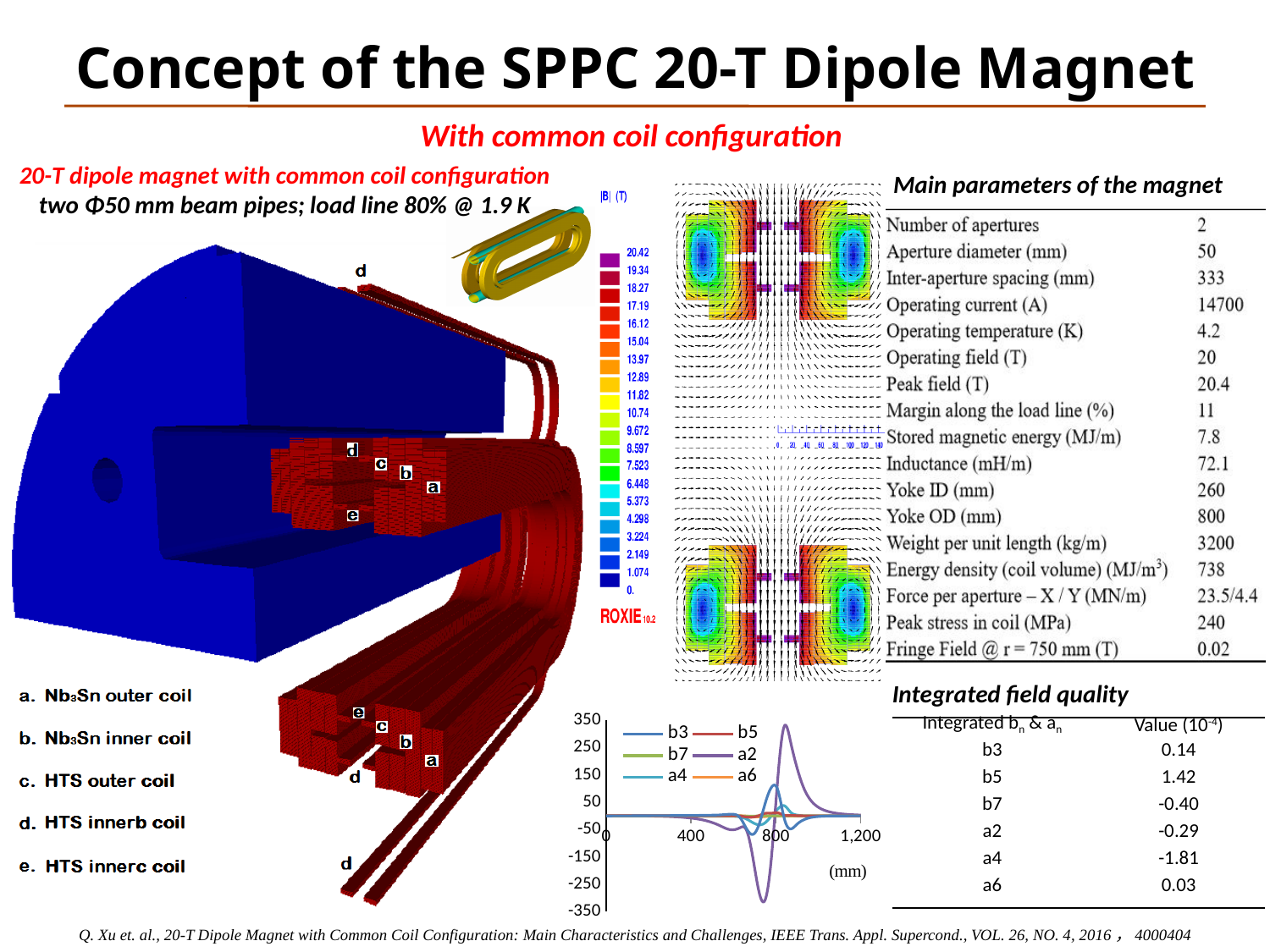
Which series are listed in the legend of the line chart? b3, b5, b7, a2, a4, a6 How many series does the legend of the line chart list? 6 Is the peak value of the a2 series in the line chart greater or less than 250? greater What is the largest x-axis tick label shown on the line chart? 1,200 What is the maximum value shown on the y axis of the line chart? 350 Which series in the line chart reaches the lowest (most negative) value? a2 Which series in the line chart reaches the highest peak value? a2 What unit is shown on the x axis of the line chart? mm What kind of chart is shown at the bottom of the slide under 'Integrated field quality'? line chart Is the lowest value of the a2 series in the line chart greater or less than -250? less What is the minimum value shown on the y axis of the line chart? -350